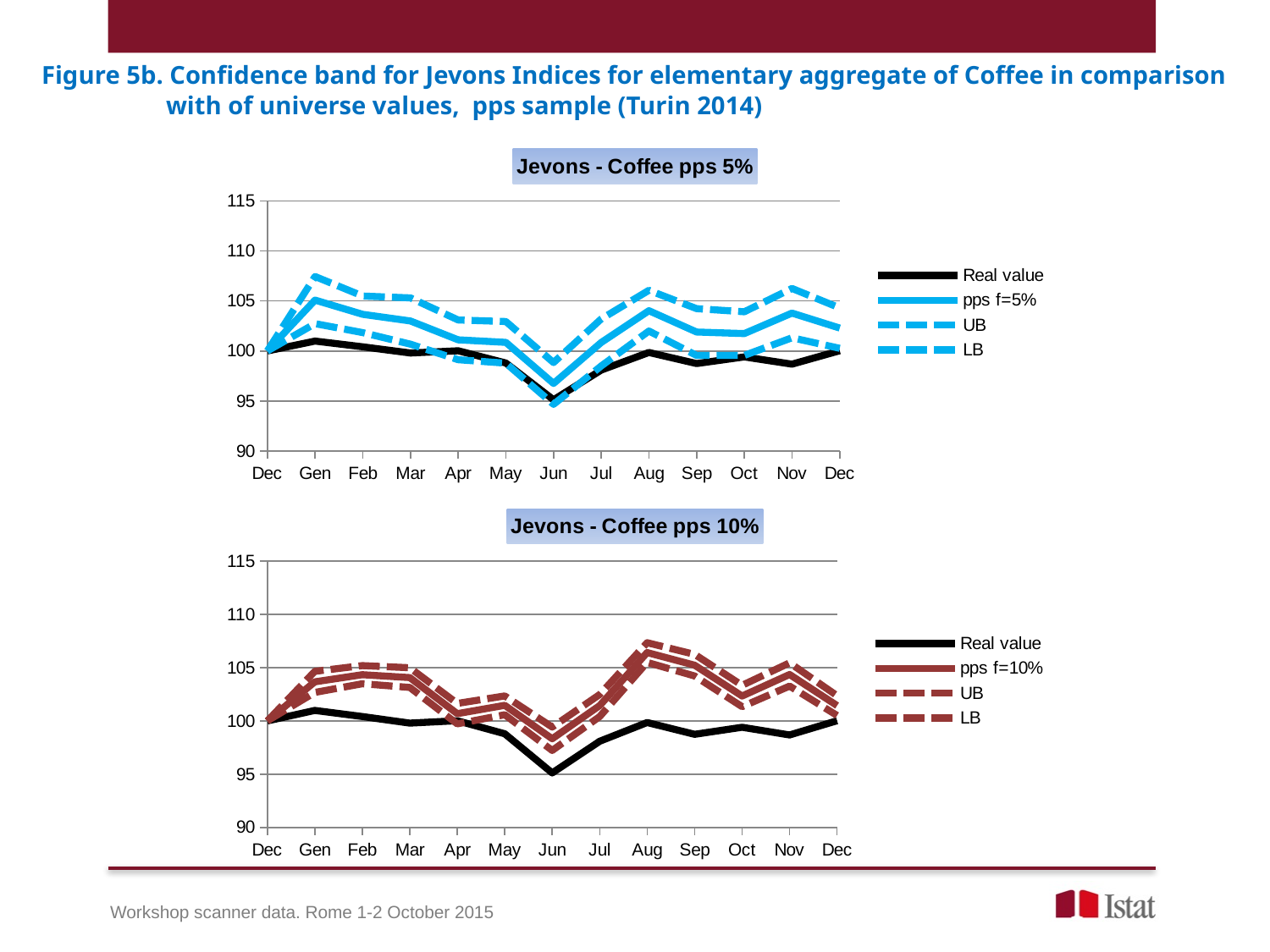
How many series does the legend of the bottom chart "Jevons - Coffee pps 10%" list? 4 In the bottom chart "Jevons - Coffee pps 10%", is the pps f=10% value in Aug greater or less than 100? greater In the bottom chart "Jevons - Coffee pps 10%", which is larger in Jun: the pps f=10% value or the Real value? pps f=10% In the bottom chart "Jevons - Coffee pps 10%", at which month is the pps f=10% series lowest? Jun What kind of chart is the top chart titled "Jevons - Coffee pps 5%"? Line chart What is the title of the bottom chart on the slide? Jevons - Coffee pps 10% In the top chart "Jevons - Coffee pps 5%", is the Real value in Jun greater or less than 100? less How many points are plotted along the x axis of the top chart "Jevons - Coffee pps 5%"? 13 In the top chart "Jevons - Coffee pps 5%", which legend entry is drawn as a solid black line? Real value In the top chart "Jevons - Coffee pps 5%", at which month is the Real value series lowest? Jun In the top chart "Jevons - Coffee pps 5%", does the Real value series rise or fall from Apr to Jun? Fall